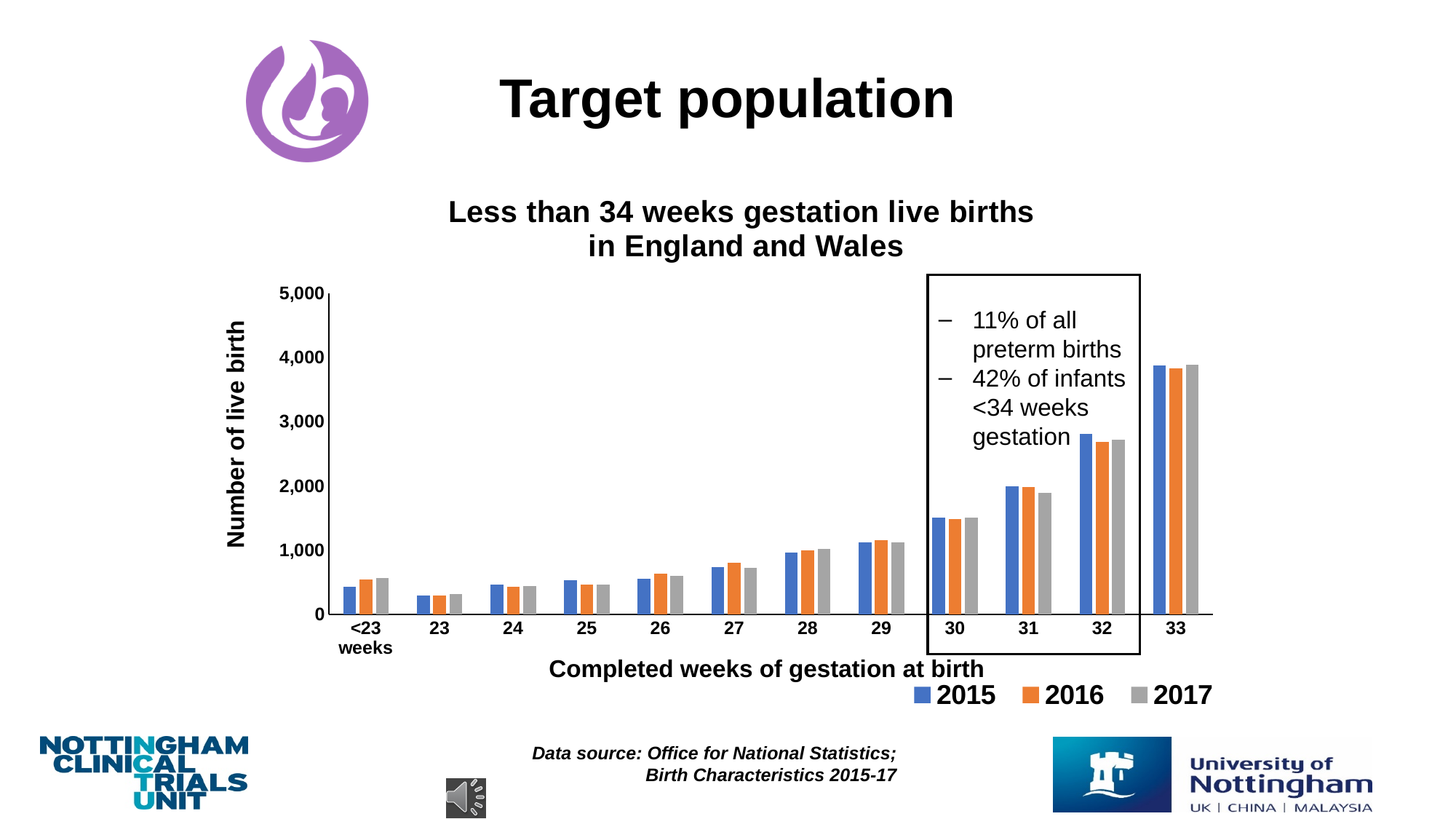
Is the 2015 value for 32 weeks greater or less than 3,000? less Do the numbers of live births generally rise or fall as completed weeks of gestation increase from 23 to 33? Rise Which completed week of gestation has the highest number of live births? 33 How many gestation-week categories are shown on the x axis? 12 Which colour represents 2016 in the legend? Orange What is the title of the chart? Less than 34 weeks gestation live births in England and Wales Is the 2015 value for 30 weeks greater or less than 1,000? greater How many series does the chart legend list? 3 Which completed week of gestation has the lowest number of live births? 23 What kind of chart is shown on the slide? Bar chart Is the 2015 value for 33 weeks greater or less than 3,000? greater Which has more live births in 2015: 32 weeks or 33 weeks? 33 weeks